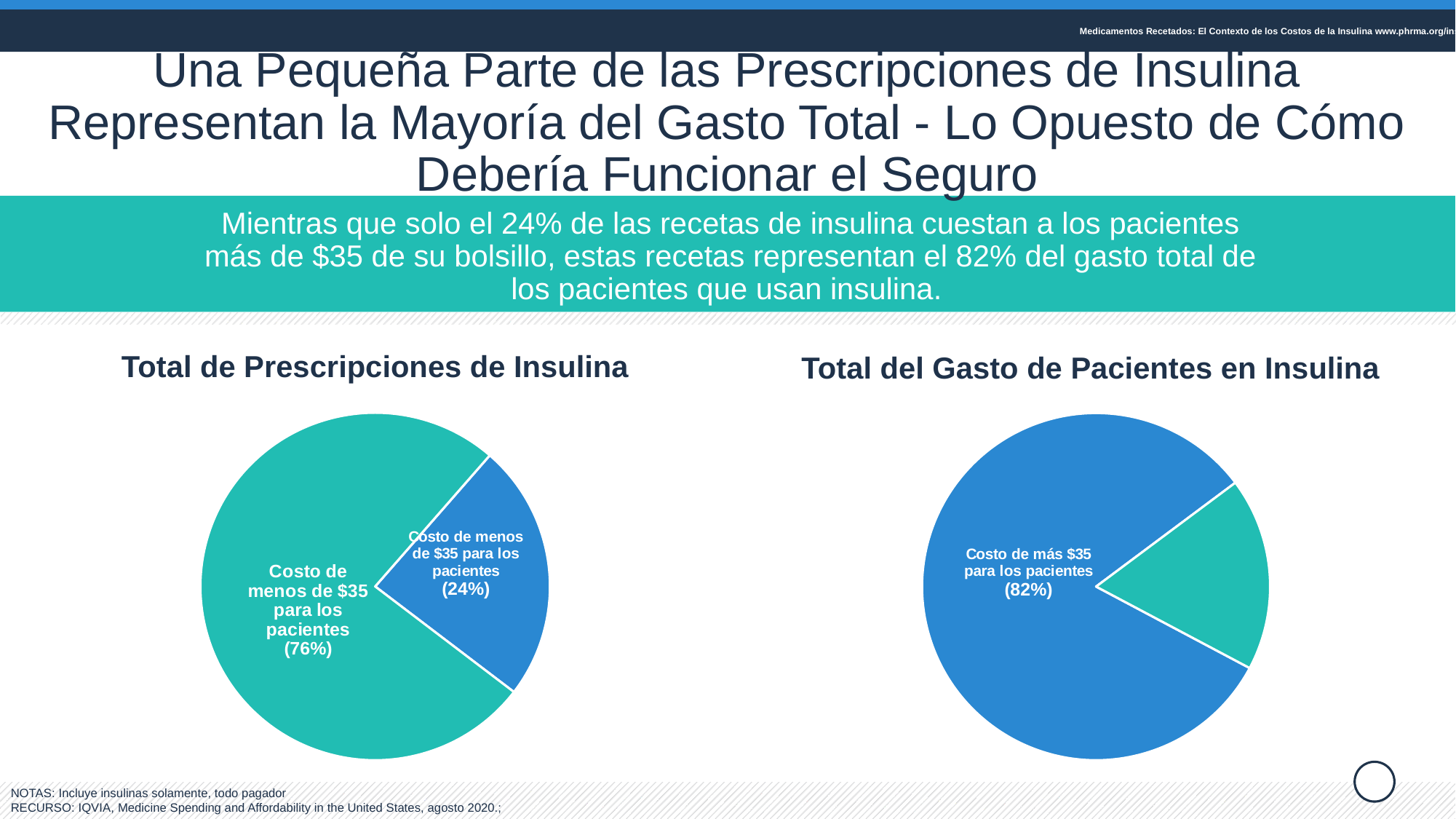
In the right chart, "Total del Gasto de Pacientes en Insulina", what percentage is shown for "Costo de más $35 para los pacientes"? 82% How many slices does the right chart, "Total del Gasto de Pacientes en Insulina", have? 2 In the right chart, "Total del Gasto de Pacientes en Insulina", which slice is larger, the blue one or the teal one? The blue one (82%) How many pie charts are shown on the slide? 2 In the left chart, "Total de Prescripciones de Insulina", what is the difference in percentage points between the two slices? 52 percentage points What is the title of the chart on the right side of the slide? Total del Gasto de Pacientes en Insulina In the left chart, "Total de Prescripciones de Insulina", which slice is larger, the teal one or the blue one? The teal one (76%) In the left chart, "Total de Prescripciones de Insulina", what percentage is shown on the large teal slice? 76% In the left chart, "Total de Prescripciones de Insulina", what percentage is shown on the smaller blue slice? 24% What kind of chart is used on the left, titled "Total de Prescripciones de Insulina"? Pie chart How many slices does the left chart, "Total de Prescripciones de Insulina", have? 2 What kind of chart is used on the right, titled "Total del Gasto de Pacientes en Insulina"? Pie chart